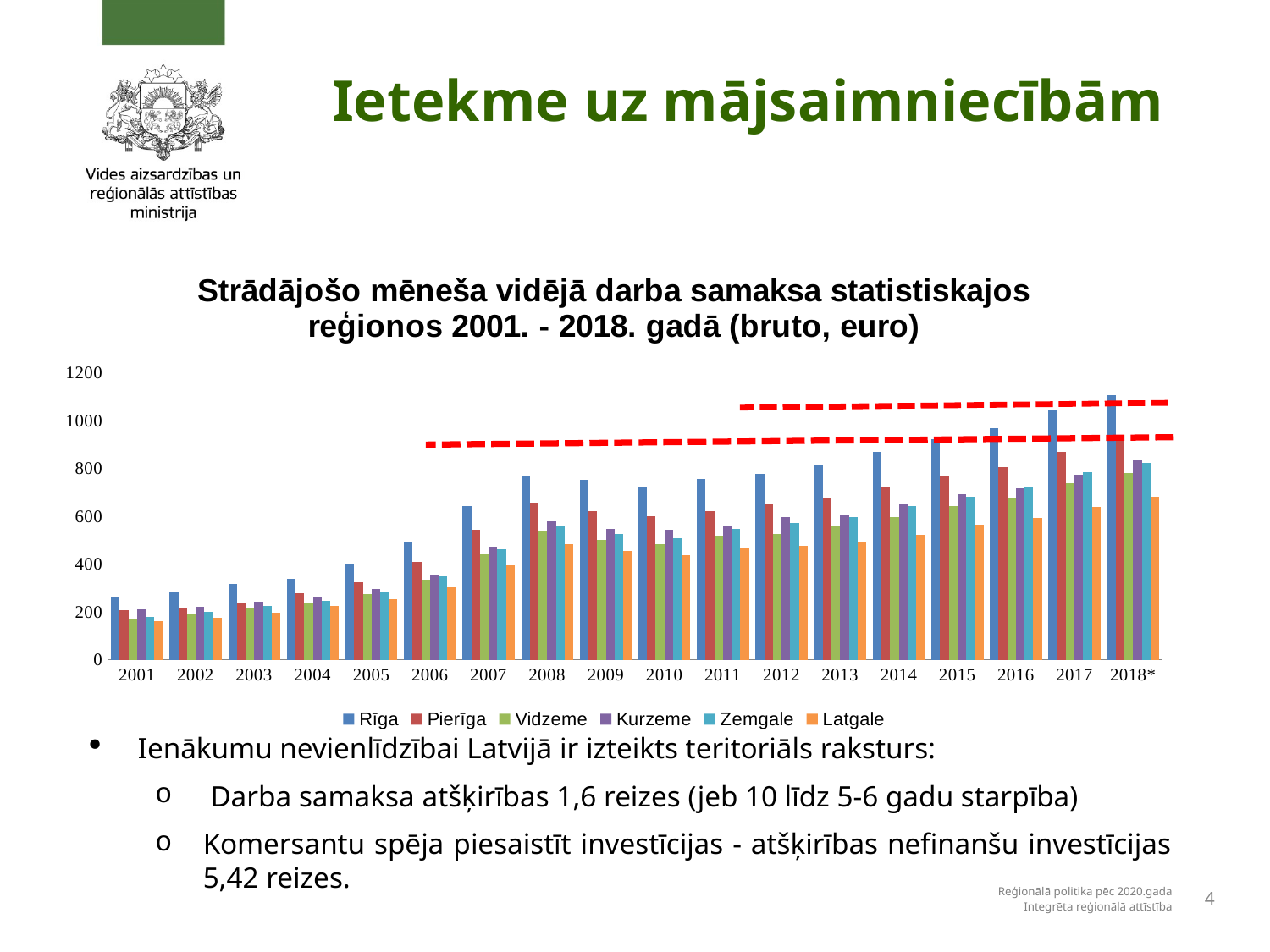
How many series does the chart legend list? 6 Which region has the lowest bar in 2018*? Latgale Is the value for Latgale in 2018* greater or less than 800? less How many years (categories) are shown on the x axis of the chart? 18 What kind of chart is shown on the slide? bar chart In which year is the Rīga bar the highest? 2018* Is the value for Rīga in 2010 greater or less than 800? less In which year is the Rīga bar the lowest? 2001 Which region has the highest bar in 2018*? Rīga Which is larger in 2017, the value for Rīga or the value for Latgale? Rīga Is the value for Rīga in 2018* greater or less than 1000? greater Do the Rīga values generally rise or fall from 2001 to 2018*? rise